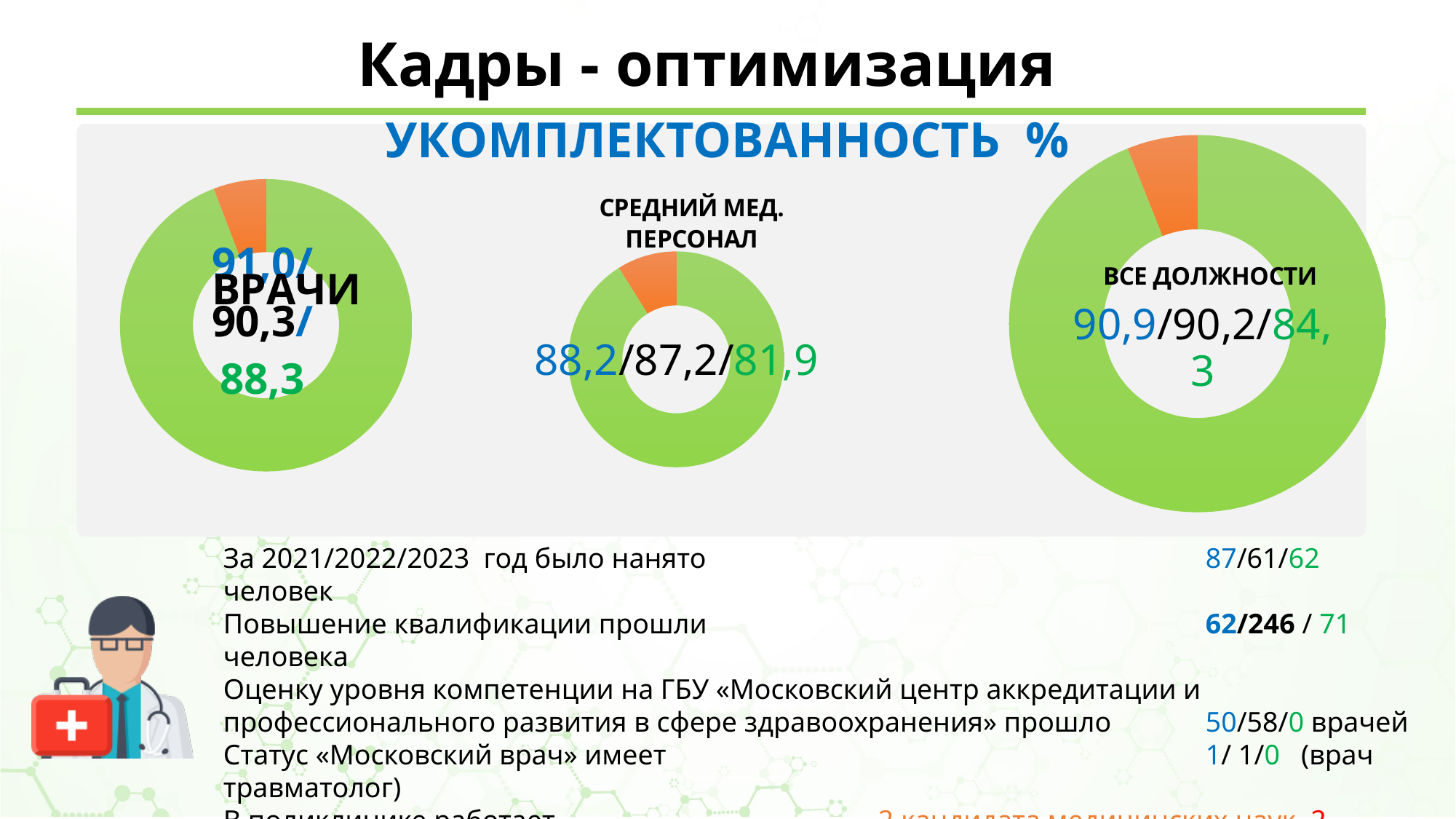
On the ВСЕ ДОЛЖНОСТИ chart, what is the first (blue) value printed? 90,9 What three values are printed on the ВРАЧИ chart? 91,0/90,3/88,3 What three values are printed on the ВСЕ ДОЛЖНОСТИ chart? 90,9/90,2/84,3 On the ВРАЧИ chart, what is the last (green) value printed? 88,3 Which chart has the lowest green (last) value printed: ВРАЧИ, СРЕДНИЙ МЕД. ПЕРСОНАЛ or ВСЕ ДОЛЖНОСТИ? СРЕДНИЙ МЕД. ПЕРСОНАЛ What kind of chart is used for the ВРАЧИ chart? Donut (pie) chart Do the three values printed on the СРЕДНИЙ МЕД. ПЕРСОНАЛ chart rise or fall from first to last? Fall What is the title of the middle donut chart? СРЕДНИЙ МЕД. ПЕРСОНАЛ How many donut charts are shown under the heading УКОМПЛЕКТОВАННОСТЬ %? 3 On the ВРАЧИ chart, what is the difference between the first value (91,0) and the last value (88,3)? 2,7 Which is larger: the green value on the ВРАЧИ chart (88,3) or the green value on the СРЕДНИЙ МЕД. ПЕРСОНАЛ chart (81,9)? ВРАЧИ (88,3) What three values are printed on the СРЕДНИЙ МЕД. ПЕРСОНАЛ chart? 88,2/87,2/81,9